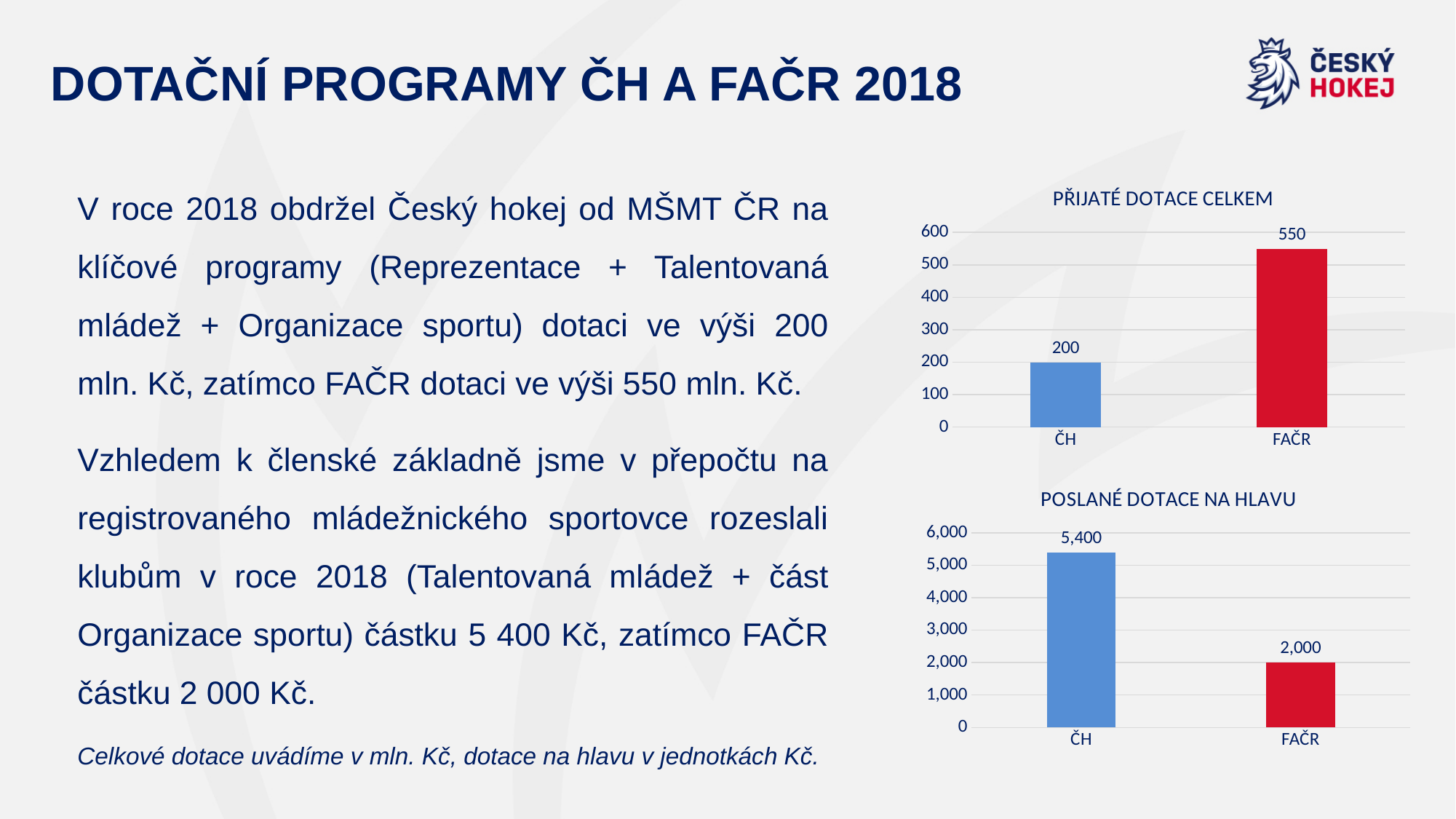
In the chart titled POSLANÉ DOTACE NA HLAVU, what is the difference between the values for ČH and FAČR? 3,400 In the chart titled POSLANÉ DOTACE NA HLAVU, what is the value for ČH? 5,400 In the chart titled PŘIJATÉ DOTACE CELKEM, which category has the highest value? FAČR In the chart titled POSLANÉ DOTACE NA HLAVU, which category has the lowest value? FAČR In the chart titled PŘIJATÉ DOTACE CELKEM, what is the value for FAČR? 550 In the chart titled PŘIJATÉ DOTACE CELKEM, is the value for FAČR greater or less than 400? greater What type of chart is the chart titled POSLANÉ DOTACE NA HLAVU? bar chart In the chart titled PŘIJATÉ DOTACE CELKEM, what is the value for ČH? 200 In the chart titled PŘIJATÉ DOTACE CELKEM, what is the difference between the values for FAČR and ČH? 350 In the chart titled POSLANÉ DOTACE NA HLAVU, what is the value for FAČR? 2,000 In the chart titled POSLANÉ DOTACE NA HLAVU, which is larger, the value for ČH or the value for FAČR? ČH How many categories are shown in the chart titled PŘIJATÉ DOTACE CELKEM? 2